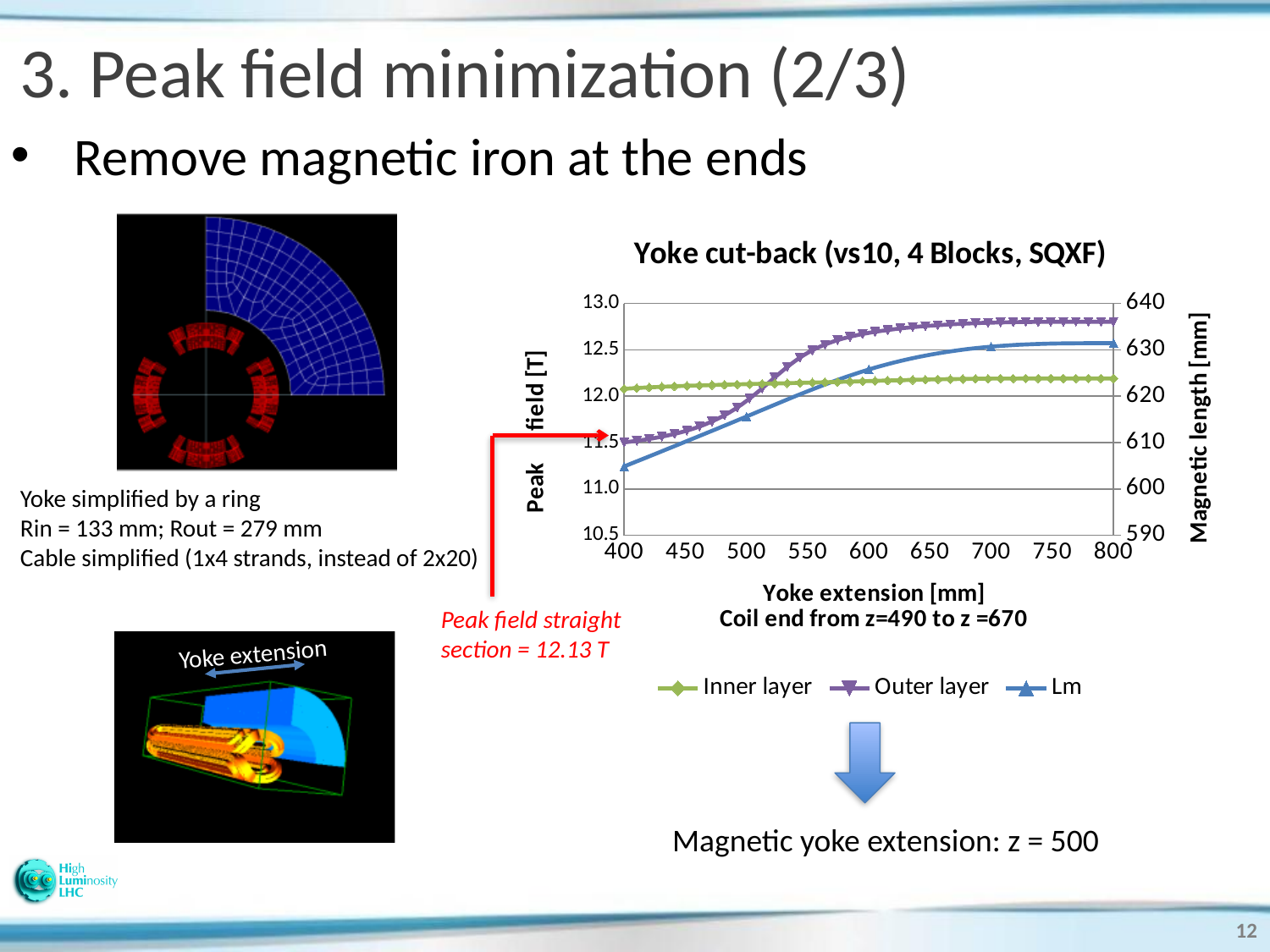
Does the Outer layer peak field rise or fall as the yoke extension increases from 400 to 800 mm? rise At a yoke extension of 400 mm, which series has the higher peak field, Inner layer or Outer layer? Inner layer At a yoke extension of 800 mm, which series has the higher peak field, Inner layer or Outer layer? Outer layer Is the Lm value at a yoke extension of 800 mm greater or less than 620 mm? greater Is the Outer layer value at a yoke extension of 400 mm greater or less than 12.0 T? less What is the title of the chart? Yoke cut-back (vs10, 4 Blocks, SQXF) Is the Outer layer value at a yoke extension of 800 mm greater or less than 12.5 T? greater What kind of chart is shown on the slide? line chart How many series does the chart legend list? 3 Which series are listed in the chart legend? Inner layer, Outer layer, Lm